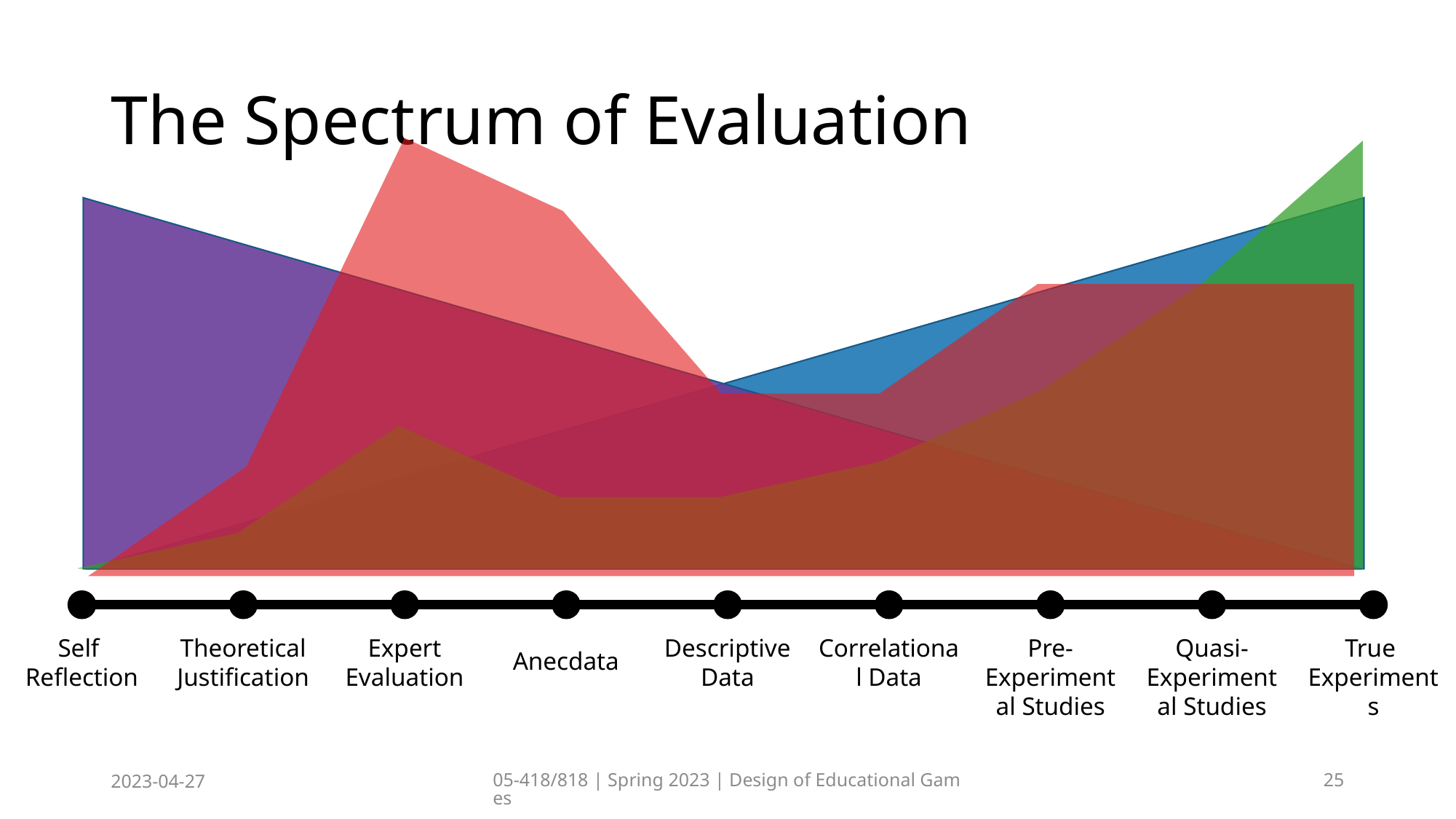
Does the red area rise or fall from Expert Evaluation to Descriptive Data? Falls What is the title of the chart on the slide? The Spectrum of Evaluation Is the red area higher at Expert Evaluation or at Descriptive Data? Expert Evaluation Which category is the first one on the left of the x axis? Self Reflection Does the green area rise or fall from Self Reflection to True Experiments? Rises At which category does the green area reach its highest value? True Experiments How many categories are labelled along the x axis of the chart? 9 At which category is the red area at its lowest value? Self Reflection What kind of chart is shown on the slide? Area chart At which category does the red area reach its highest value? Expert Evaluation Is the blue area higher at Self Reflection or at Correlational Data? Self Reflection At which category is the green area at its lowest value? Self Reflection